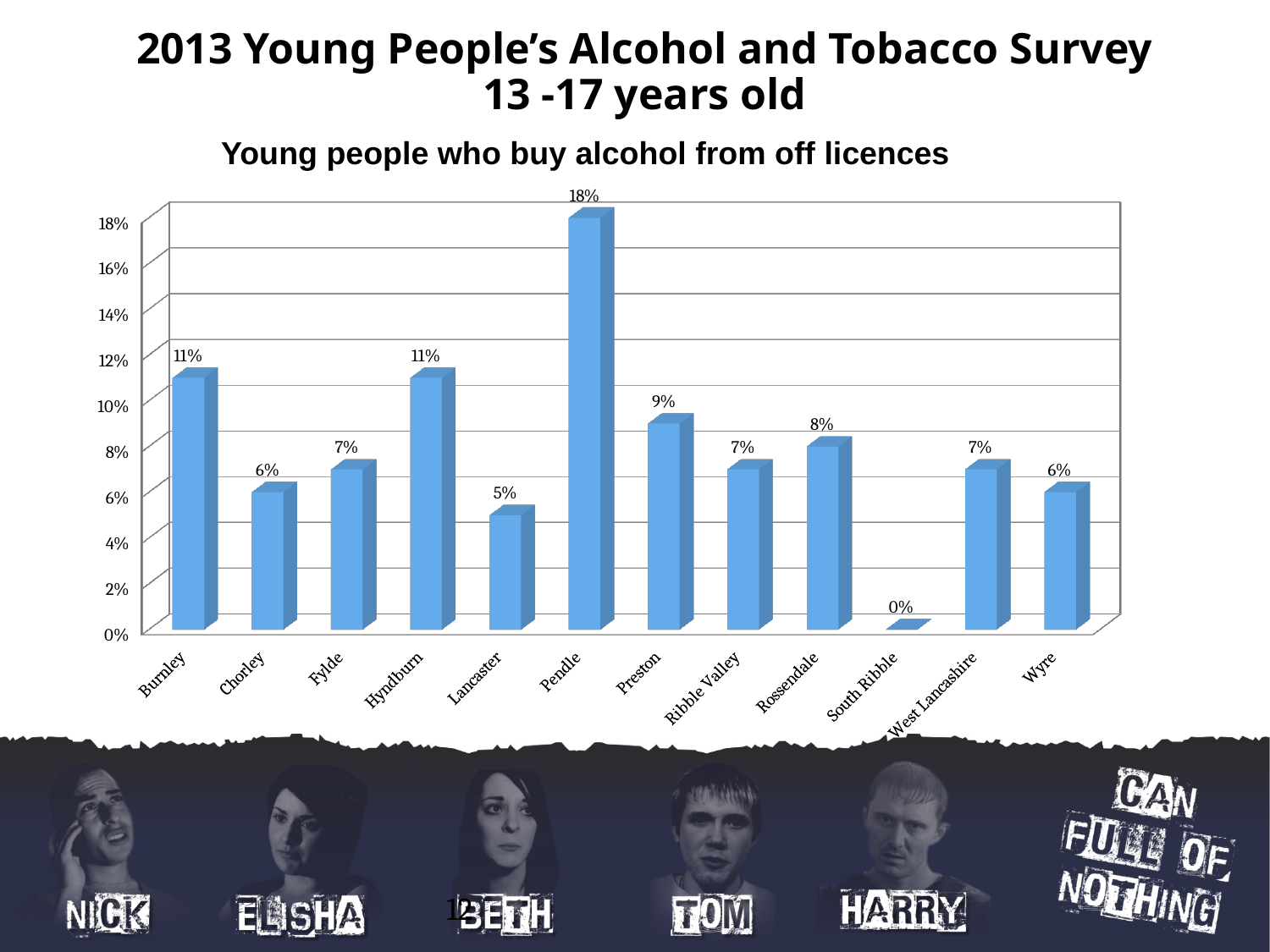
What kind of chart is shown on the slide? Bar chart Which is larger, the value for Burnley or the value for Chorley? Burnley What is the title of the chart? Young people who buy alcohol from off licences What is the value shown for Rossendale? 8% Which area has the lowest value on the chart? South Ribble What is the difference between the values for Pendle and Preston? 9% What is the difference between the values for Burnley and Wyre? 5% Which area has the highest percentage of young people buying alcohol from off licences? Pendle What percentage of young people in Pendle buy alcohol from off licences? 18% What is the value shown for Lancaster? 5% Is the value for Hyndburn greater or less than 10%? greater How many areas are shown on the x axis of the chart? 12